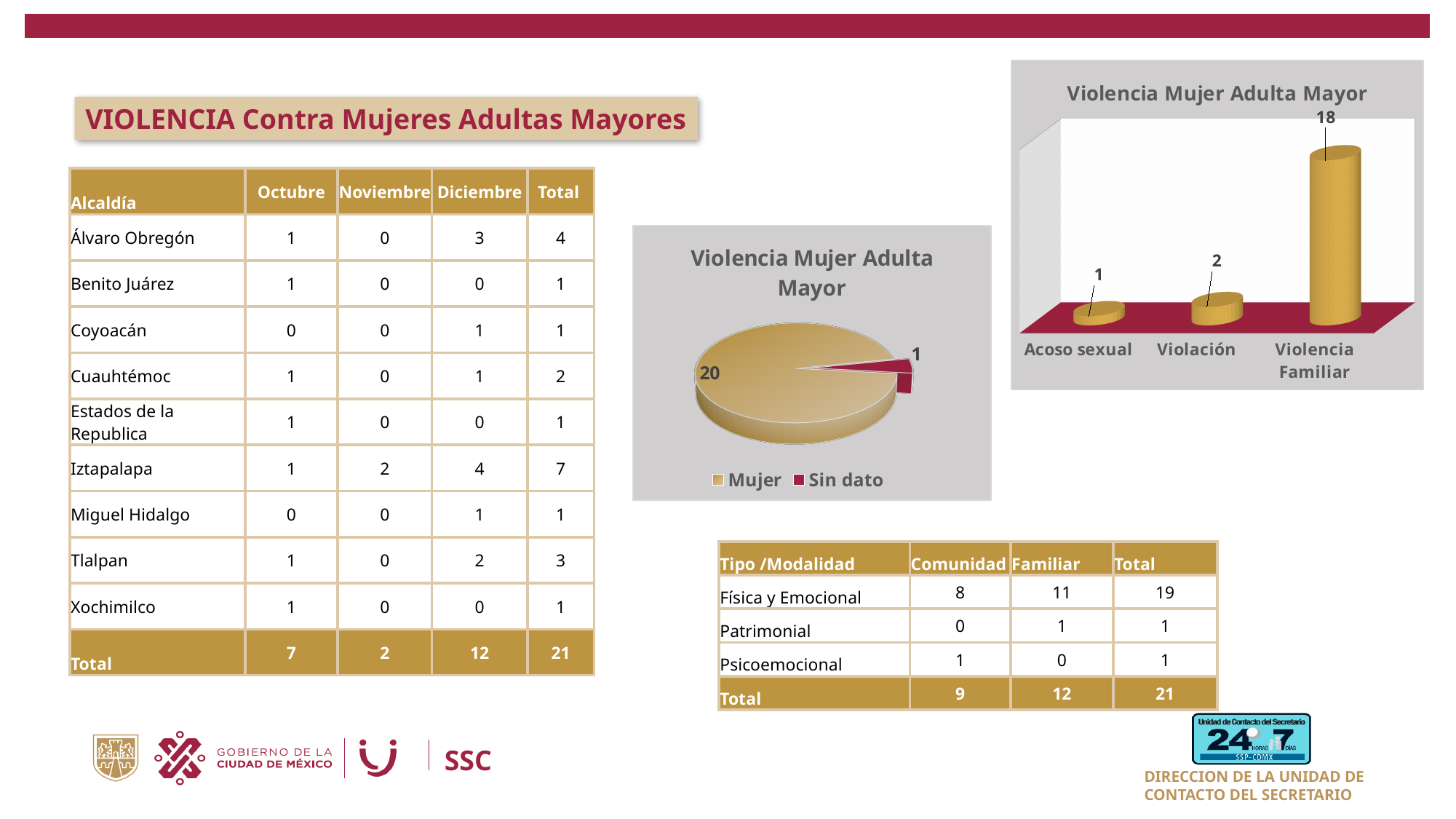
In the pie chart in the middle of the slide, how many entries does the legend list? 2 In the bar chart on the right of the slide, which category has the highest value? Violencia Familiar In the pie chart in the middle of the slide, what is the difference between the Mujer and Sin dato values? 19 In the pie chart in the middle of the slide, what is the value for Mujer? 20 What kind of chart is the chart in the middle of the slide? Pie chart In the bar chart on the right of the slide, how many categories are shown? 3 In the pie chart in the middle of the slide, what is the value for Sin dato? 1 In the bar chart on the right of the slide, which category has the lowest value? Acoso sexual In the pie chart in the middle of the slide, which slice is larger, Mujer or Sin dato? Mujer In the bar chart on the right of the slide, what is the difference between Violencia Familiar and Violación? 16 In the bar chart on the right of the slide, what is the value for Violación? 2 In the bar chart on the right of the slide, what is the value for Violencia Familiar? 18